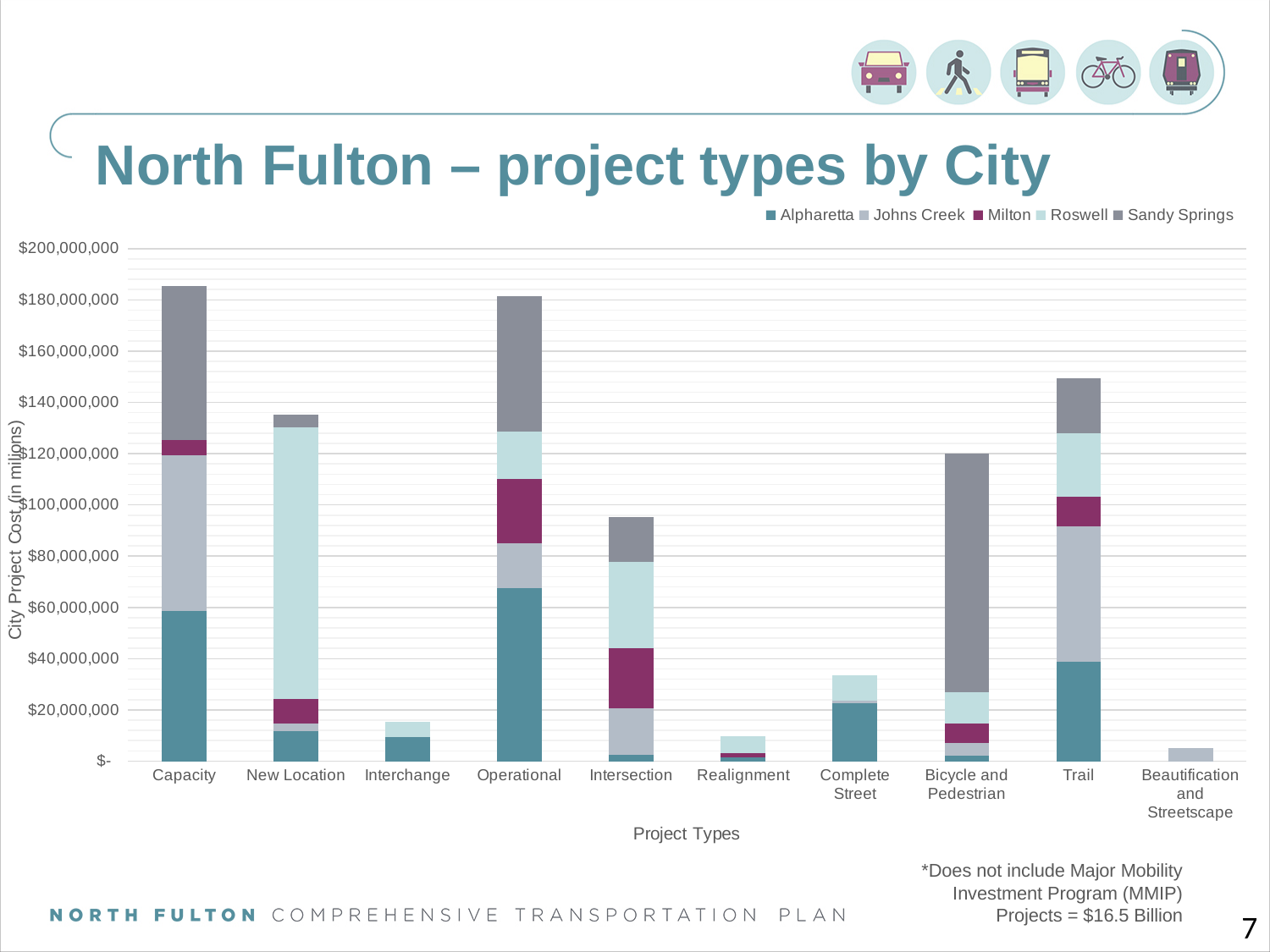
What is the label on the x axis of the chart? Project Types Is the total value for Trail greater or less than $140,000,000? greater Which has a larger total city project cost, Trail or Intersection? Trail Is the total value for Capacity greater or less than $160,000,000? greater Is the total value for Interchange greater or less than $20,000,000? less Which project type has the lowest total city project cost? Beautification and Streetscape How many cities does the legend list? 5 What is the label on the y axis of the chart? City Project Cost (in millions) Which has a larger total city project cost, Complete Street or Realignment? Complete Street How many project type categories are shown on the x axis? 10 What kind of chart is shown on the slide? Stacked bar chart